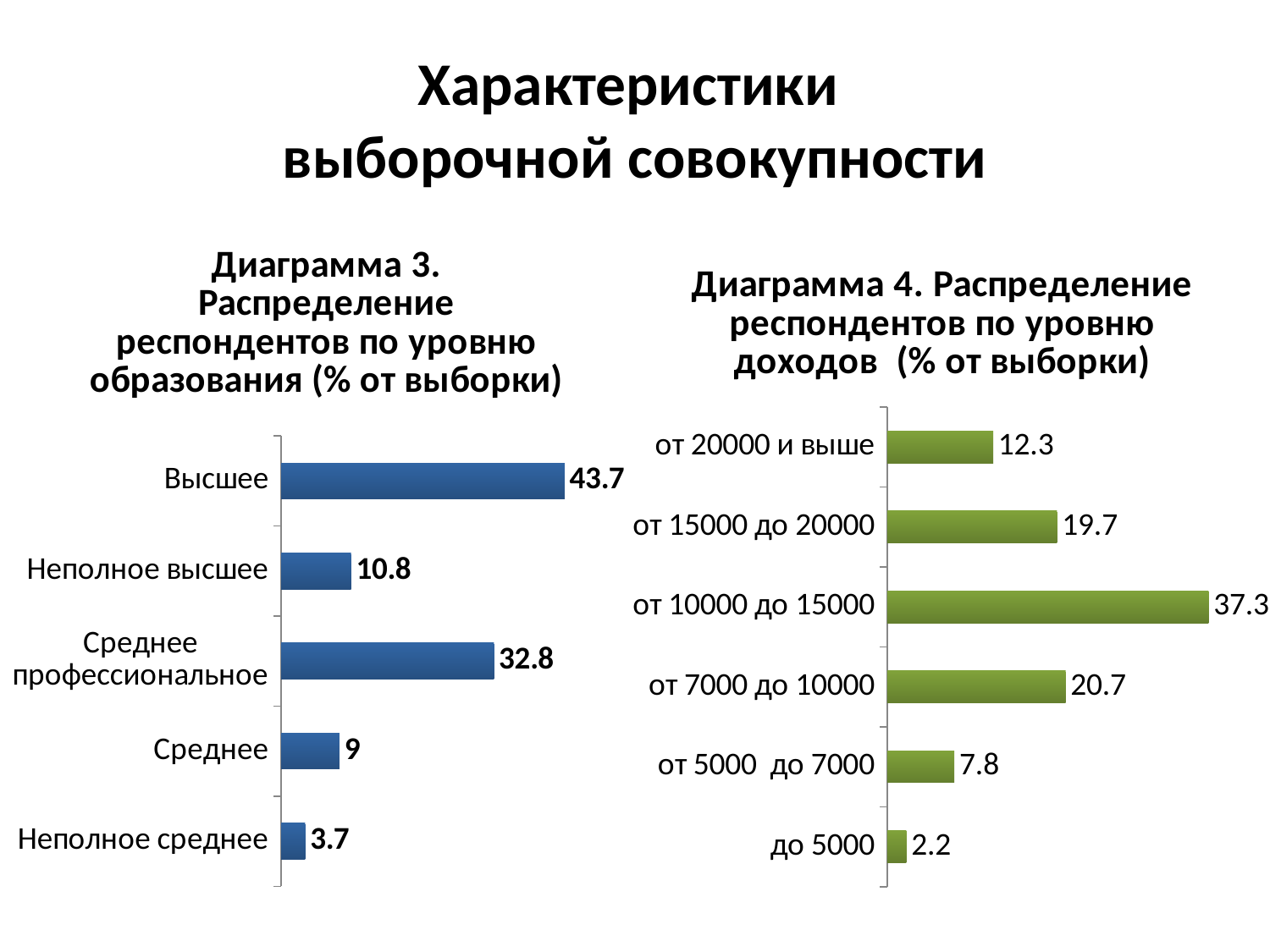
In Диаграмма 3 (education level chart), what is the value for Высшее? 43.7 In Диаграмма 3 (education level chart), how many categories are shown? 5 In Диаграмма 4 (income level chart), which category has the highest value? от 10000 до 15000 In Диаграмма 3 (education level chart), what is the value for Среднее профессиональное? 32.8 In Диаграмма 4 (income level chart), what is the difference between от 15000 до 20000 and от 20000 и выше? 7.4 What type of chart is Диаграмма 4 (income level chart)? Bar chart In Диаграмма 4 (income level chart), what is the value for до 5000? 2.2 In Диаграмма 4 (income level chart), what is the value for от 7000 до 10000? 20.7 In Диаграмма 4 (income level chart), how many income categories are shown? 6 In Диаграмма 3 (education level chart), which is larger: Среднее or Неполное высшее? Неполное высшее In Диаграмма 3 (education level chart), which category has the lowest value? Неполное среднее In Диаграмма 3 (education level chart), what is the difference between Высшее and Неполное высшее? 32.9